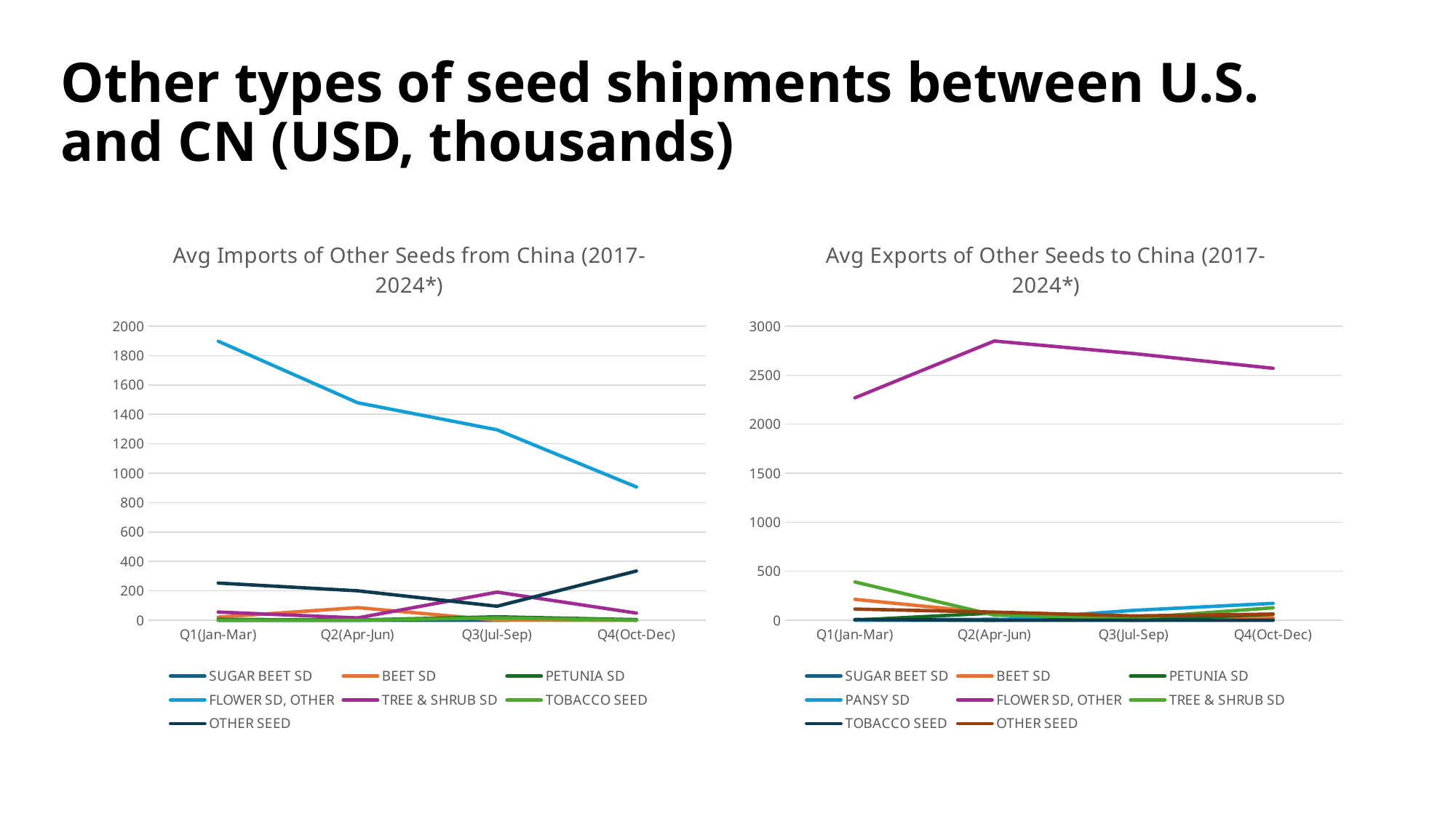
In the "Avg Imports of Other Seeds from China (2017-2024*)" chart, does the FLOWER SD, OTHER line rise or fall from Q1(Jan-Mar) to Q4(Oct-Dec)? Fall What type of chart is the "Avg Imports of Other Seeds from China (2017-2024*)" chart? Line chart In the "Avg Exports of Other Seeds to China (2017-2024*)" chart, is the value for FLOWER SD, OTHER at Q1(Jan-Mar) greater or less than 2500? less Which series appears in the legend of the "Avg Exports of Other Seeds to China (2017-2024*)" chart but not in the legend of the "Avg Imports of Other Seeds from China (2017-2024*)" chart? PANSY SD How many series does the legend of the "Avg Exports of Other Seeds to China (2017-2024*)" chart list? 8 How many quarters are shown on the x axis of the "Avg Imports of Other Seeds from China (2017-2024*)" chart? 4 How many series does the legend of the "Avg Imports of Other Seeds from China (2017-2024*)" chart list? 7 In the "Avg Imports of Other Seeds from China (2017-2024*)" chart, is the OTHER SEED value larger at Q1(Jan-Mar) or at Q4(Oct-Dec)? Q4(Oct-Dec) In the "Avg Exports of Other Seeds to China (2017-2024*)" chart, in which quarter does the FLOWER SD, OTHER line reach its highest value? Q2(Apr-Jun) In the "Avg Imports of Other Seeds from China (2017-2024*)" chart, which series has the highest values across all quarters? FLOWER SD, OTHER In the "Avg Imports of Other Seeds from China (2017-2024*)" chart, is the value for FLOWER SD, OTHER at Q4(Oct-Dec) greater or less than 1000? less In the "Avg Imports of Other Seeds from China (2017-2024*)" chart, is the value for FLOWER SD, OTHER at Q1(Jan-Mar) greater or less than 1800? greater